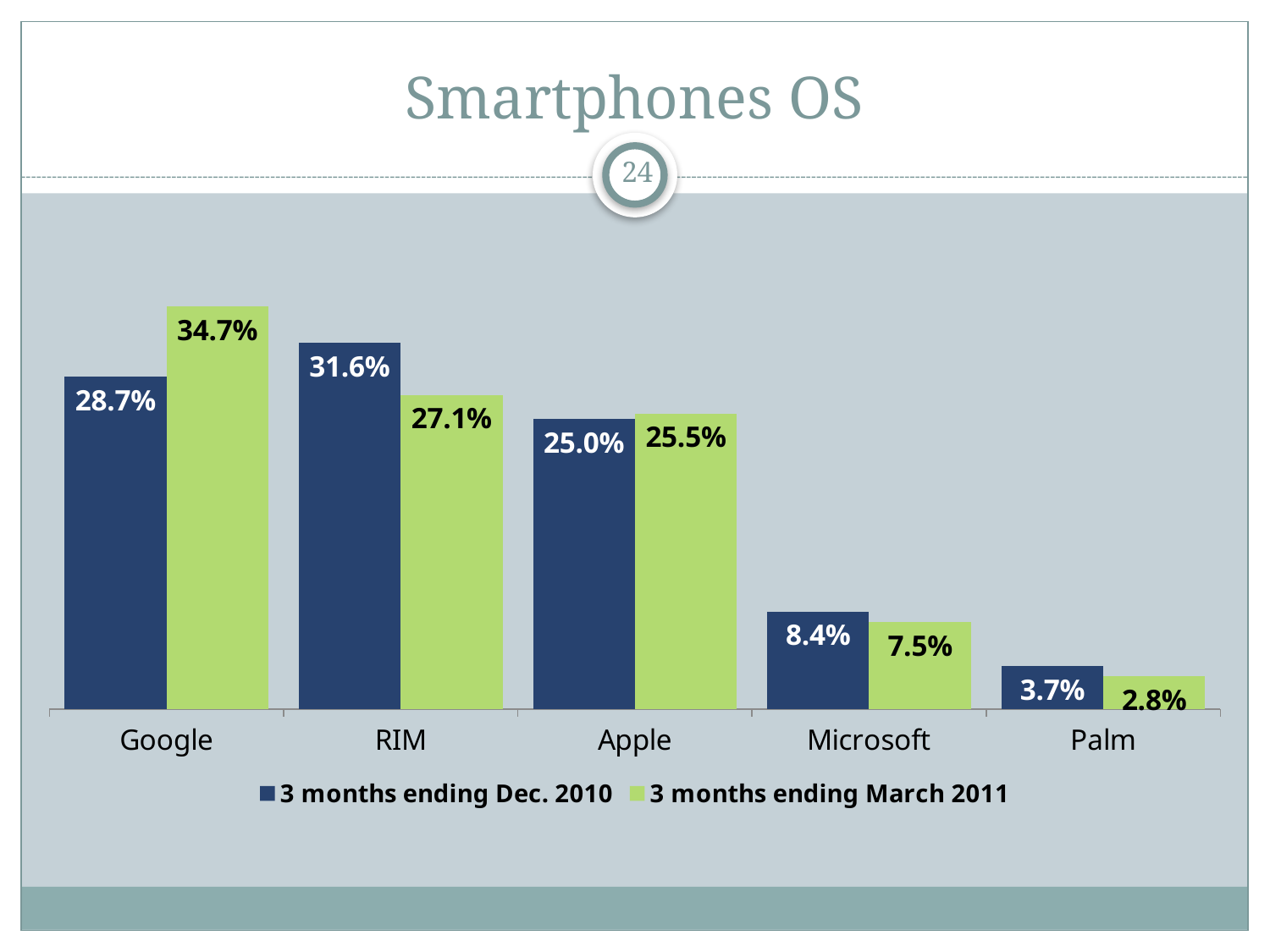
What is the difference between Google's values for the 3 months ending March 2011 and the 3 months ending Dec. 2010? 6.0% Which category has the lowest value for the 3 months ending March 2011? Palm What is the value for Microsoft for the 3 months ending March 2011? 7.5% What is the value for Google for the 3 months ending March 2011? 34.7% How many categories are shown on the x axis? 5 What kind of chart is shown on the slide? Bar chart Which category has the highest value for the 3 months ending Dec. 2010? RIM What is the difference between RIM's values for the 3 months ending Dec. 2010 and the 3 months ending March 2011? 4.5% What is the value for RIM for the 3 months ending Dec. 2010? 31.6% What is the title of the slide? Smartphones OS How many series does the legend list? 2 Which is larger for Apple: the 3 months ending Dec. 2010 or the 3 months ending March 2011? 3 months ending March 2011